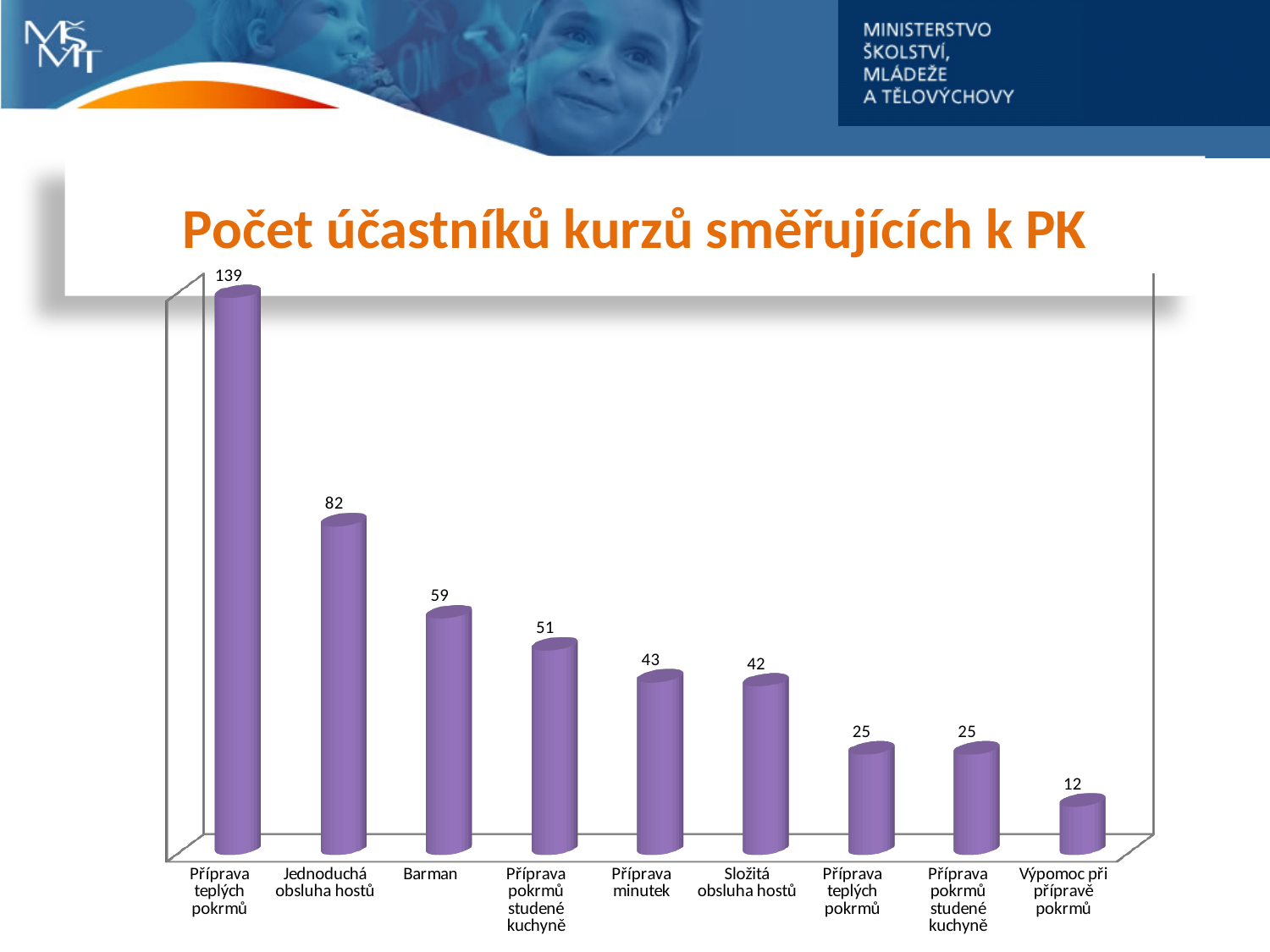
Do the values rise or fall from left to right along the x axis? fall What is the highest value shown in the chart? 139 What is the value for Barman? 59 What is the value for Výpomoc při přípravě pokrmů? 12 What is the difference between the values for Jednoduchá obsluha hostů and Barman? 23 What is the value for Příprava minutek? 43 Which is larger, the value for Barman or the value for Příprava minutek? Barman How many categories are shown in the chart? 9 What is the value for Jednoduchá obsluha hostů? 82 What is the value of the leftmost bar? 139 Which category has the lowest value? Výpomoc při přípravě pokrmů What is the value for Složitá obsluha hostů? 42